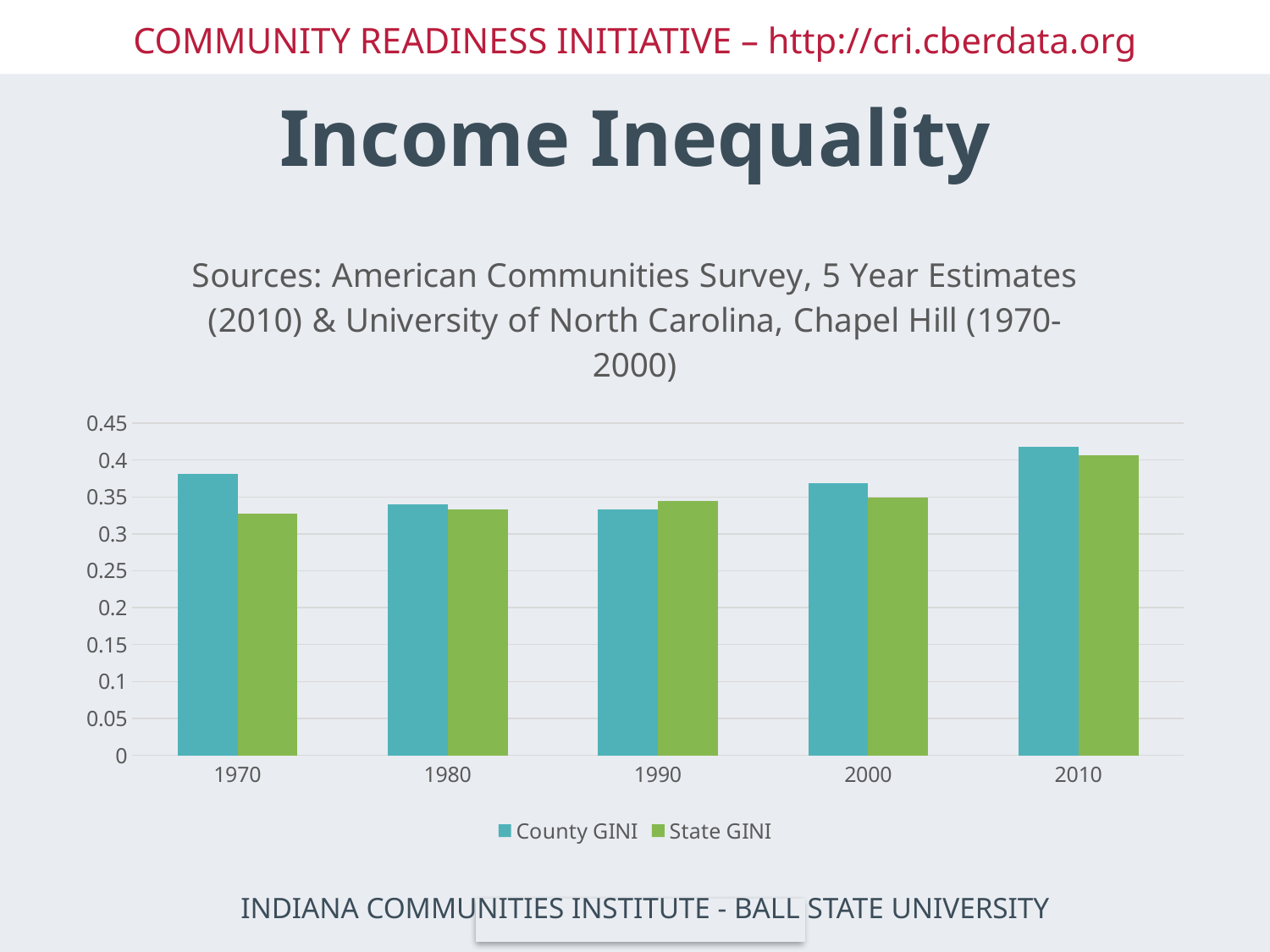
What are the two series named in the legend? County GINI and State GINI How many years are shown on the x axis? 5 What kind of chart is shown on the slide? bar chart Is the County GINI value for 1970 greater or less than 0.35? greater In 1970, which is larger, County GINI or State GINI? County GINI Is the County GINI value for 2010 greater or less than 0.4? greater Is the State GINI value for 1970 greater or less than 0.35? less Does the State GINI value rise or fall from 1970 to 2010? rise How many series does the legend list? 2 Which year has the highest County GINI value? 2010 Which year has the highest State GINI value? 2010